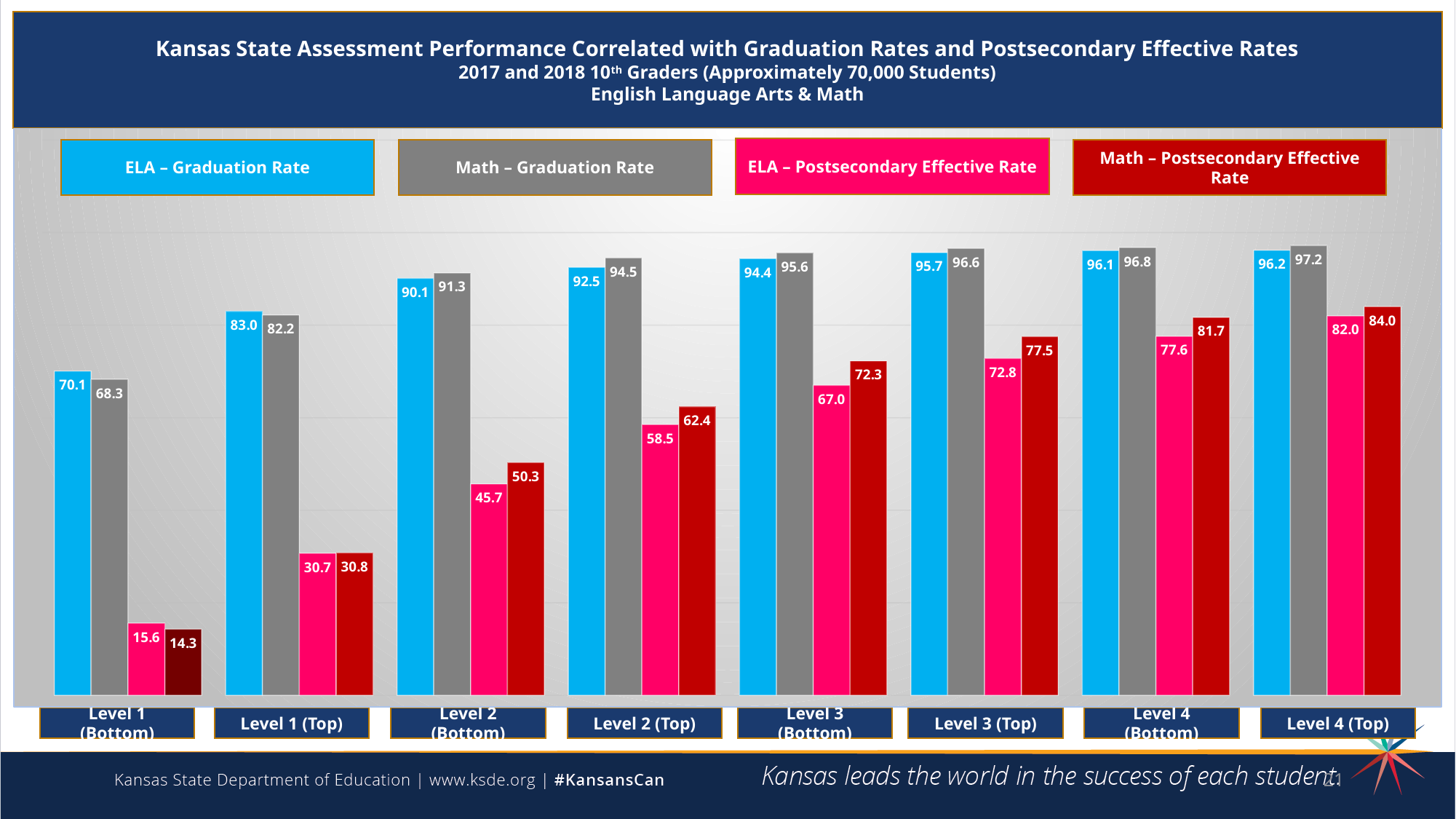
How many series does the legend list? 4 What is the difference between the Math – Graduation Rate and the ELA – Graduation Rate for Level 2 (Bottom)? 1.2 Which category has the lowest ELA – Postsecondary Effective Rate? Level 1 (Bottom) Which category has the highest Math – Graduation Rate? Level 4 (Top) Which is larger for Level 3 (Bottom): the ELA – Postsecondary Effective Rate or the Math – Postsecondary Effective Rate? Math – Postsecondary Effective Rate How many categories are shown on the x axis? 8 What is the ELA – Postsecondary Effective Rate for Level 2 (Top)? 58.5 Do the Math – Postsecondary Effective Rate values rise or fall from Level 1 (Bottom) to Level 4 (Top)? Rise What kind of chart is shown on the slide? Bar chart What is the Math – Postsecondary Effective Rate for Level 4 (Top)? 84.0 What is the ELA – Graduation Rate for Level 1 (Bottom)? 70.1 What colour represents the ELA – Graduation Rate series? Blue